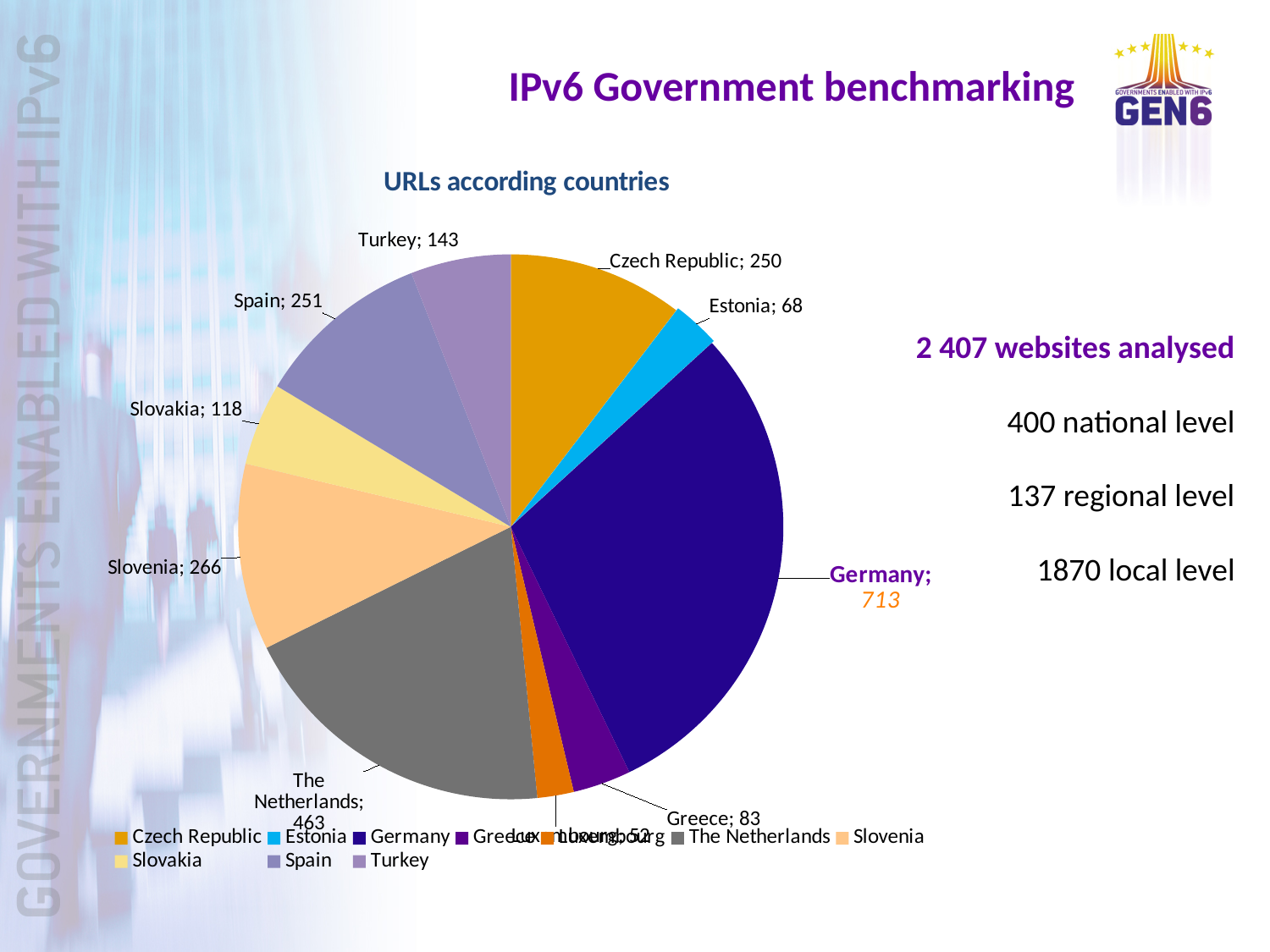
What is the value for Germany in the pie chart? 713 What is the difference between the values for Germany and The Netherlands? 250 What colour is the Germany slice in the pie chart? dark blue What is the value for Turkey in the pie chart? 143 What is the difference between the values for Slovenia and Slovakia? 148 What is the title of the chart? URLs according countries Which country has the largest slice in the pie chart? Germany Which has a larger value, Slovenia or Turkey? Slovenia What is the value for The Netherlands in the pie chart? 463 What is the value for Estonia in the pie chart? 68 What kind of chart is shown on the slide? pie chart How many countries are shown in the pie chart? 10